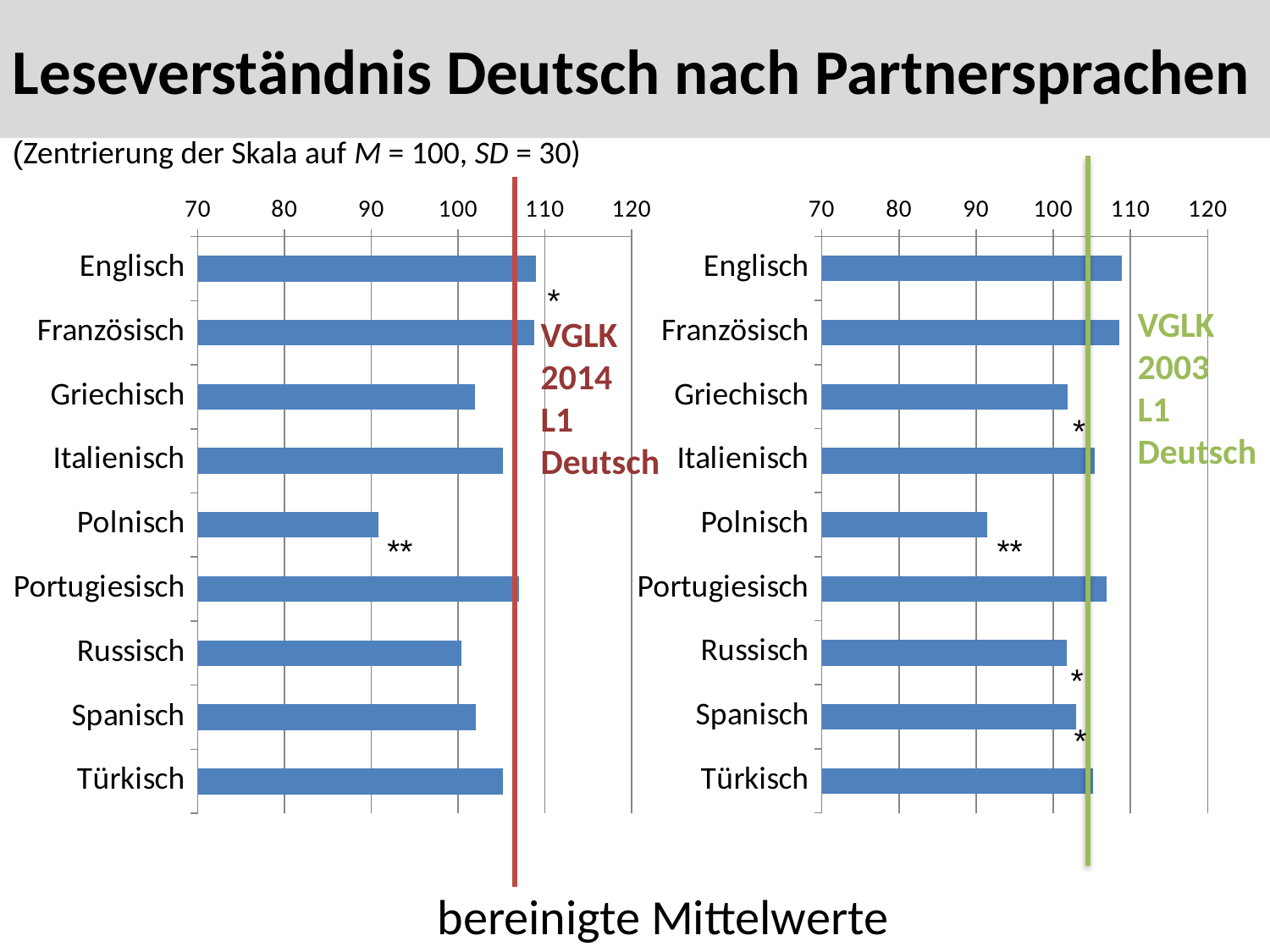
On the right chart (VGLK 2003), which language has the lowest value? Polnisch What kind of chart is the left chart (VGLK 2014)? bar chart On the left chart (VGLK 2014), is the value for Polnisch greater or less than 100? less On the left chart (VGLK 2014), which language has the lowest value? Polnisch What is the title of the slide containing the two charts? Leseverständnis Deutsch nach Partnersprachen On the left chart (VGLK 2014), is the value for Englisch greater or less than 100? greater How many language categories are shown on the left chart (VGLK 2014)? 9 On the right chart (VGLK 2003), which is larger, the value for Englisch or the value for Griechisch? Englisch On the right chart (VGLK 2003), is the value for Portugiesisch greater or less than 100? greater How many language categories are shown on the right chart (VGLK 2003)? 9 On the left chart (VGLK 2014), which is larger, the value for Italienisch or the value for Polnisch? Italienisch